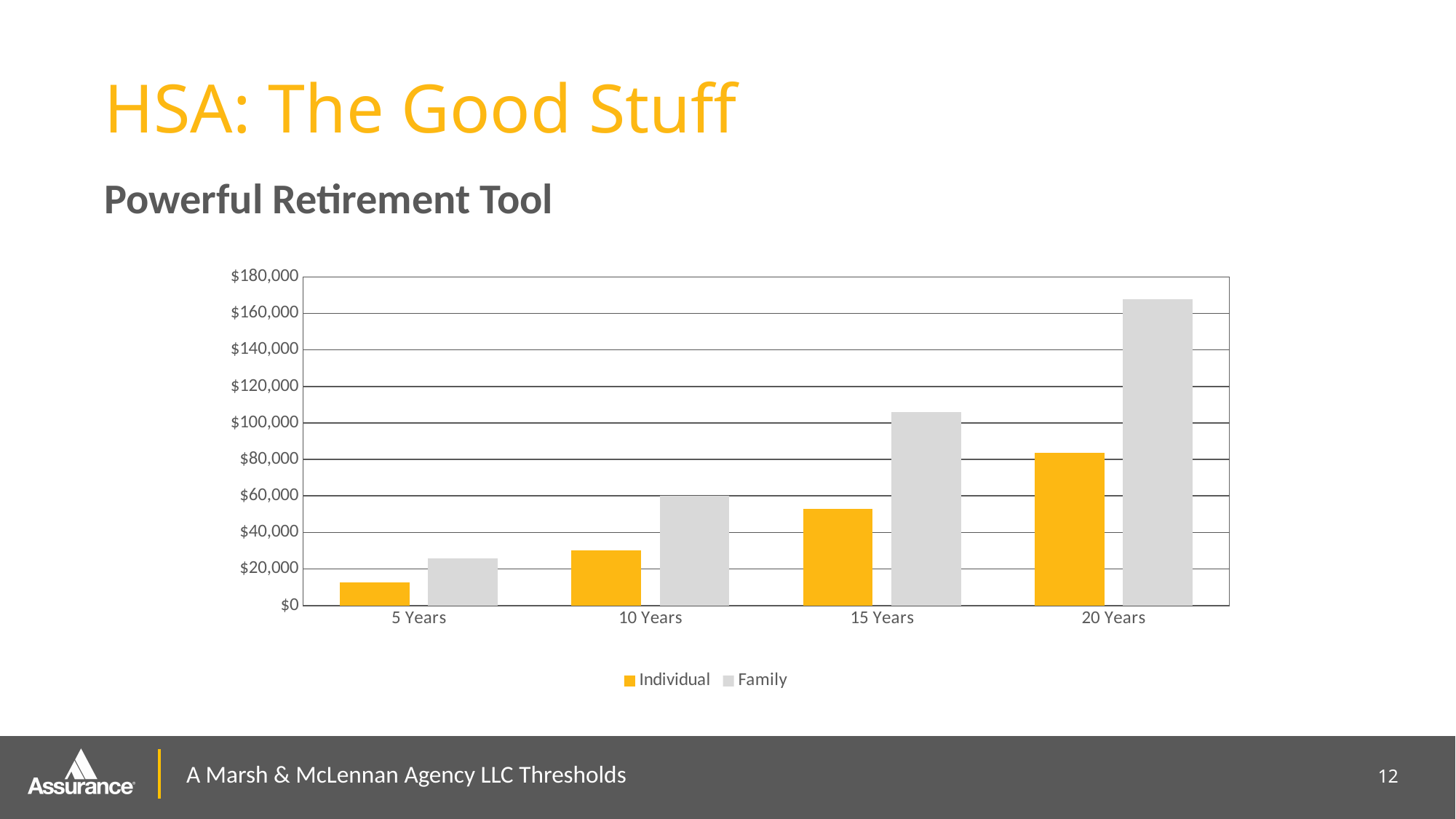
Which colour represents the Family series in the chart? grey How many categories are shown on the x axis? 4 Is the Family value for 15 Years greater or less than $100,000? greater Is the Family value for 20 Years greater or less than $160,000? greater Which category has the lowest Individual value? 5 Years What kind of chart is shown on the slide? bar chart Which is larger at 15 Years, the Individual value or the Family value? Family Do the Individual values rise or fall as the number of years increases? rise How many series does the legend list? 2 Is the Individual value for 5 Years greater or less than $20,000? less Which category has the highest Family value? 20 Years